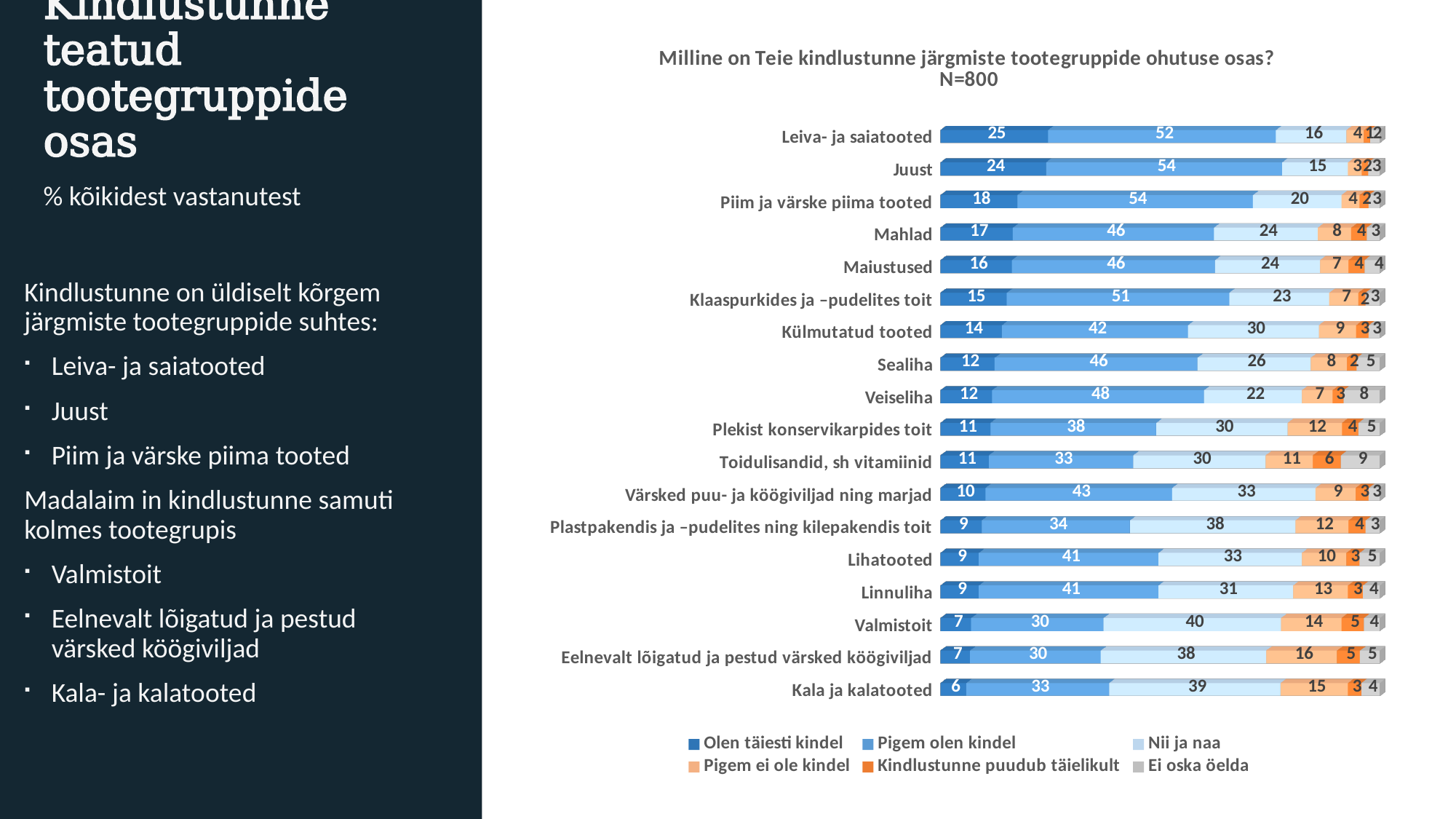
Which product group has the lowest "Olen täiesti kindel" value? Kala ja kalatooted How many product groups are shown in the chart? 18 How many series does the legend list? 6 What kind of chart is shown on the slide? Stacked bar chart What sample size (N) is stated in the chart title? N=800 What percentage of respondents answered "Olen täiesti kindel" for Leiva- ja saiatooted? 25 What is the "Nii ja naa" value for Valmistoit? 40 What is the "Pigem ei ole kindel" value for Eelnevalt lõigatud ja pestud värsked köögiviljad? 16 What is the difference between the "Pigem olen kindel" values for Juust and Valmistoit? 24 Which has a larger "Nii ja naa" value, Külmutatud tooted or Sealiha? Külmutatud tooted Which product group has the highest "Ei oska öelda" value? Toidulisandid, sh vitamiinid Which product group has the highest "Olen täiesti kindel" value? Leiva- ja saiatooted